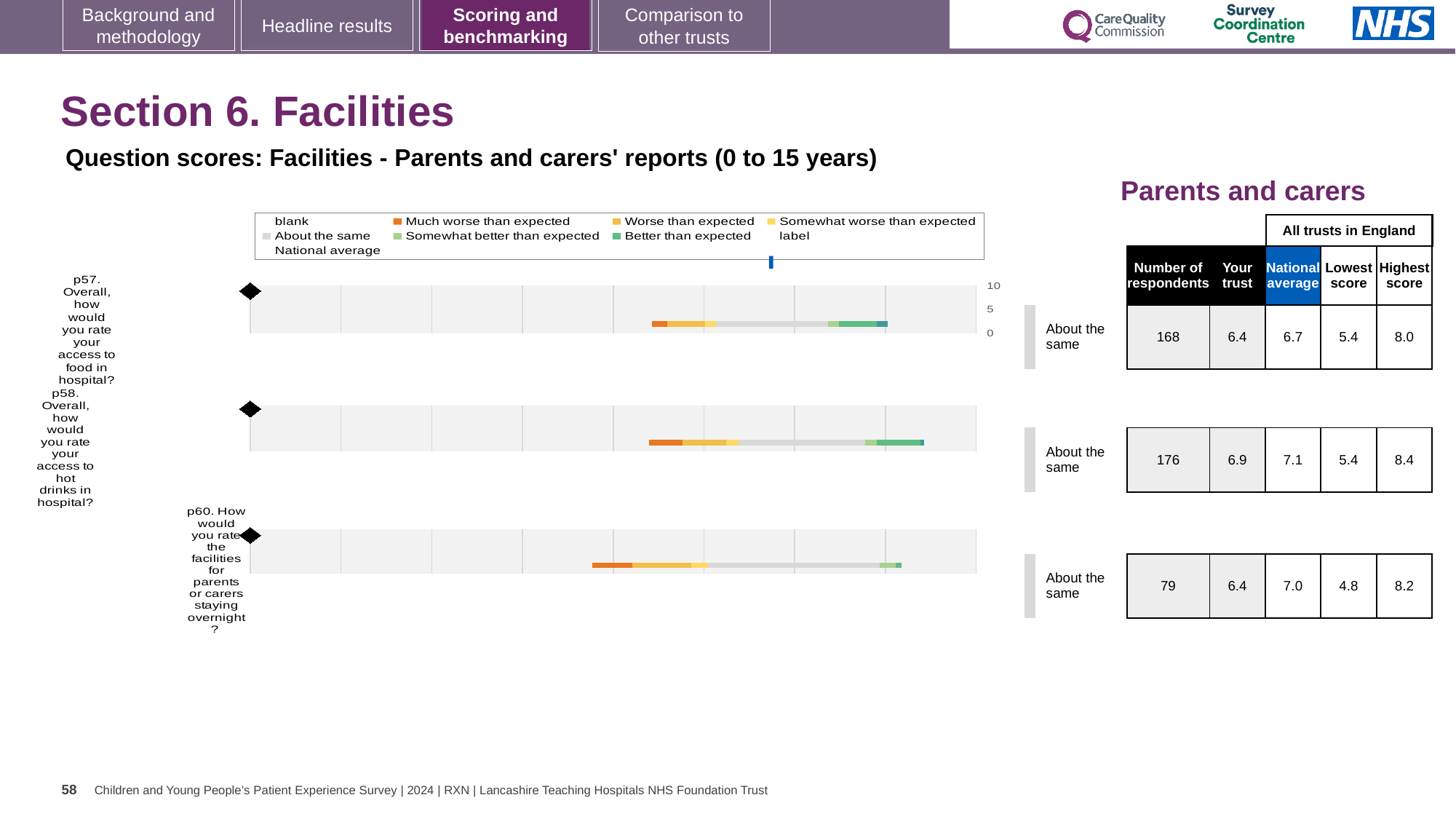
What is the national average score for p58 (access to hot drinks in hospital)? 7.1 For p58, what is the difference between the highest score and the lowest score across all trusts in England? 3.0 For p57, which is larger: the 'Your trust' score or the national average? National average What benchmark category is shown for all three questions? About the same What is the 'Your trust' score for p57 (access to food in hospital)? 6.4 For p60, what is the difference between the national average and the 'Your trust' score? 0.6 Is the 'Your trust' score for p60 greater or less than 5? greater Which question has the lowest 'Lowest score' across all trusts in England? p60 What kind of chart is used to show the question scores for p57, p58 and p60? bar chart How many respondents answered p60 (facilities for parents or carers staying overnight)? 79 How many survey questions are plotted on the slide? 3 Which question has the highest 'Your trust' score? p58